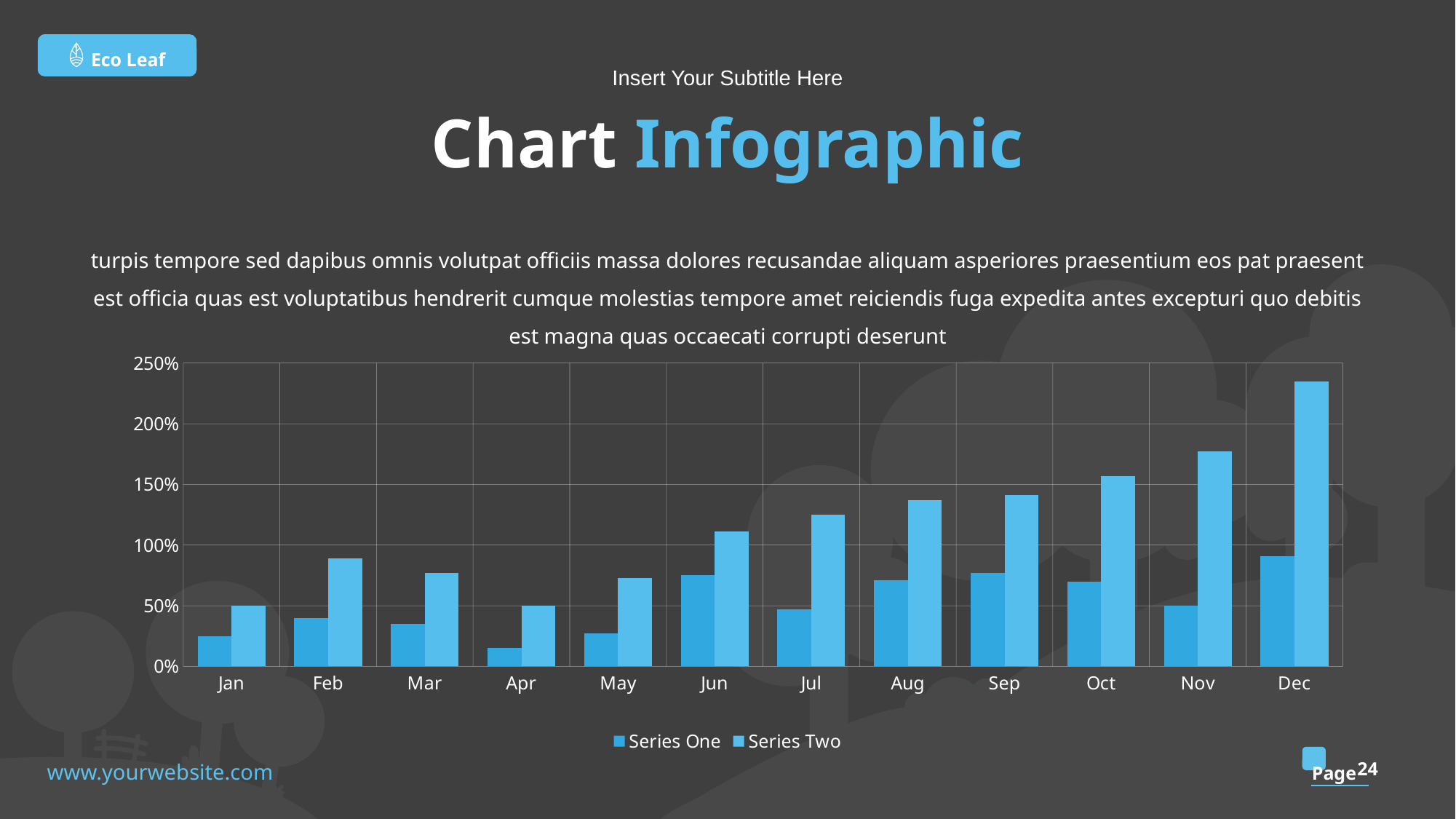
Which is larger in Jun, Series One or Series Two? Series Two How many months are shown on the x axis of the chart? 12 Which month has the lowest Series One value? Apr What are the two legend entries of the chart? Series One, Series Two Is the Series Two value for Dec greater or less than 200%? greater Is the Series One value for Dec greater or less than 100%? less What kind of chart is shown on the slide? bar chart Is the Series One value for Jan greater or less than 50%? less Which month has the highest Series Two value? Dec How many series does the chart legend list? 2 Does the Series Two value generally rise or fall from Jun to Dec? rise